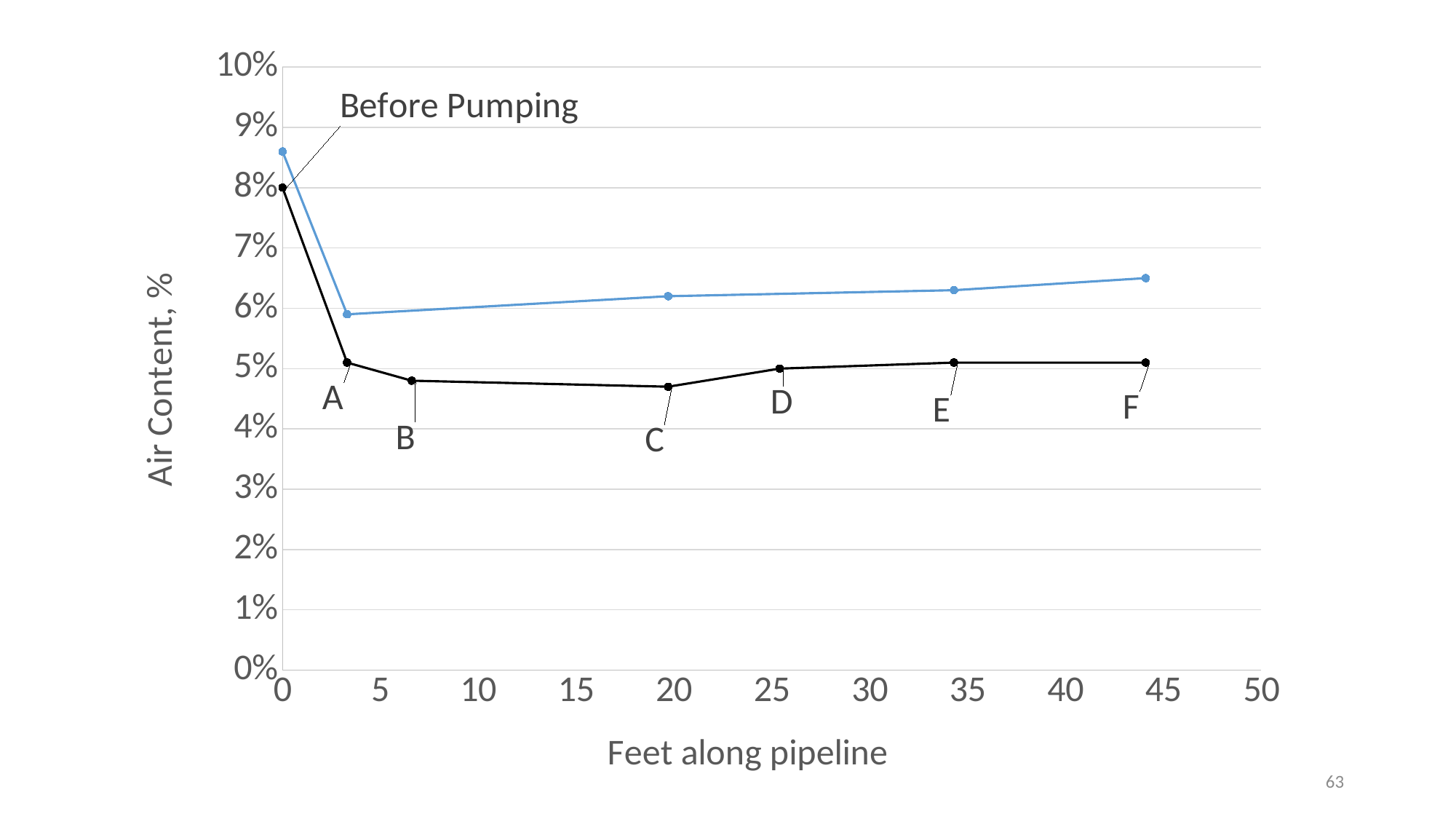
Is the value at point C greater or less than 5%? less How many lines are plotted on the chart? 2 Is the value of the Before Pumping line at its last point (around 44 feet) greater or less than 6%? greater What kind of chart is shown on the slide? line chart How many lettered points (A through F) are marked on the black line? 6 At about 20 feet along the pipeline, which line is higher, the Before Pumping line or the black line? Before Pumping What is the air content of the black line at 0 feet along the pipeline? 8% Which of the lettered points A through F has the lowest air content? C Is the value of the Before Pumping line at 0 feet greater or less than 8%? greater What is the title of the x axis? Feet along pipeline What is the title of the y axis? Air Content, %